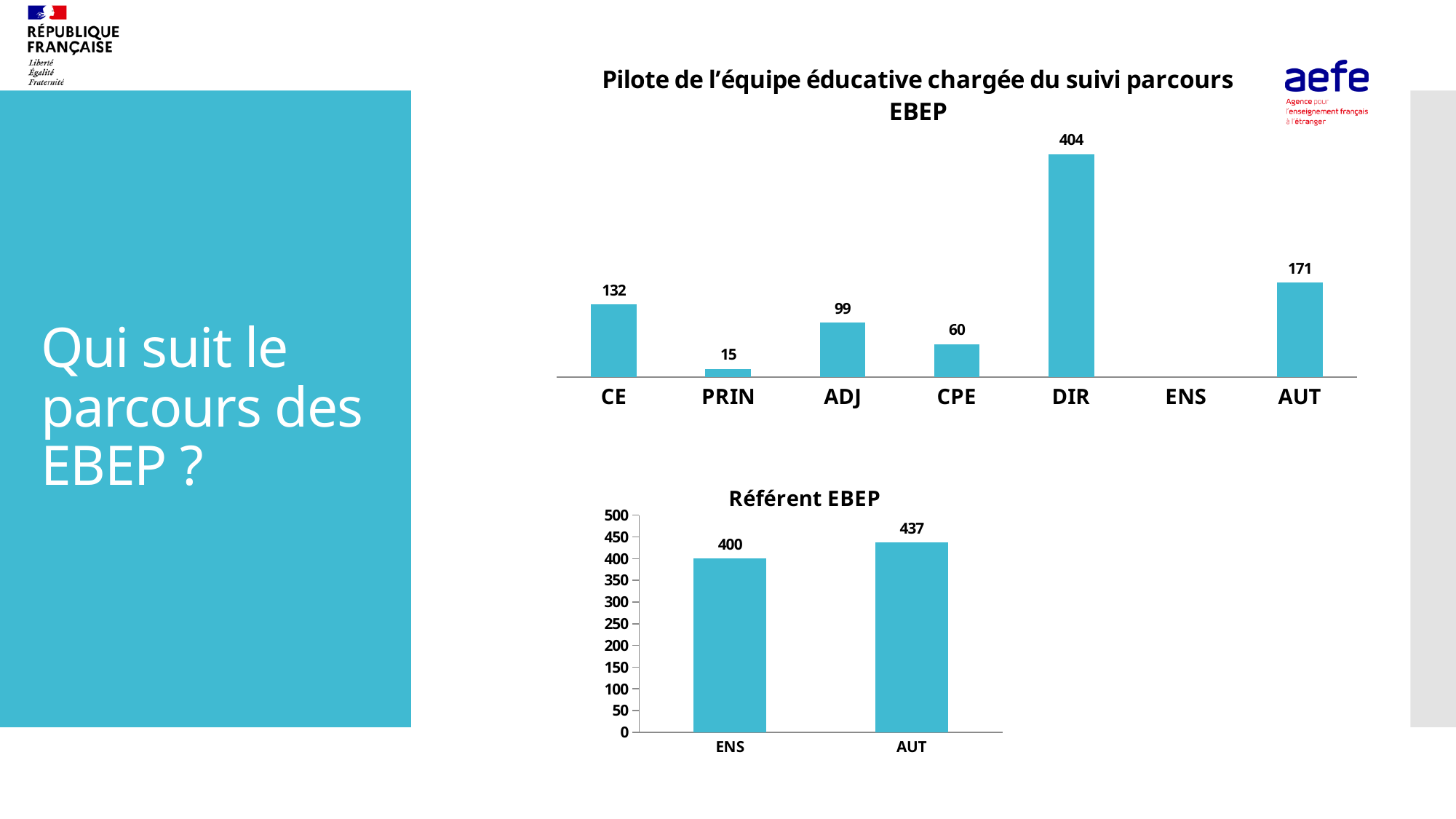
In the chart titled 'Pilote de l'équipe éducative chargée du suivi parcours EBEP', what is the value for DIR? 404 In the chart titled 'Pilote de l'équipe éducative chargée du suivi parcours EBEP', which labelled bar has the lowest value? PRIN In the chart titled 'Pilote de l'équipe éducative chargée du suivi parcours EBEP', what is the value for AUT? 171 In the chart titled 'Pilote de l'équipe éducative chargée du suivi parcours EBEP', what is the difference between the values for CE and CPE? 72 What kind of chart is the chart titled 'Référent EBEP'? Bar chart In the chart titled 'Pilote de l'équipe éducative chargée du suivi parcours EBEP', which is larger, ADJ or AUT? AUT In the chart titled 'Pilote de l'équipe éducative chargée du suivi parcours EBEP', which category has the highest value? DIR In the chart titled 'Référent EBEP', what is the difference between the values for AUT and ENS? 37 In the chart titled 'Pilote de l'équipe éducative chargée du suivi parcours EBEP', how many categories are labelled on the x axis? 7 In the chart titled 'Référent EBEP', which category has the higher value? AUT In the chart titled 'Référent EBEP', what is the value for ENS? 400 In the chart titled 'Pilote de l'équipe éducative chargée du suivi parcours EBEP', what is the value for PRIN? 15